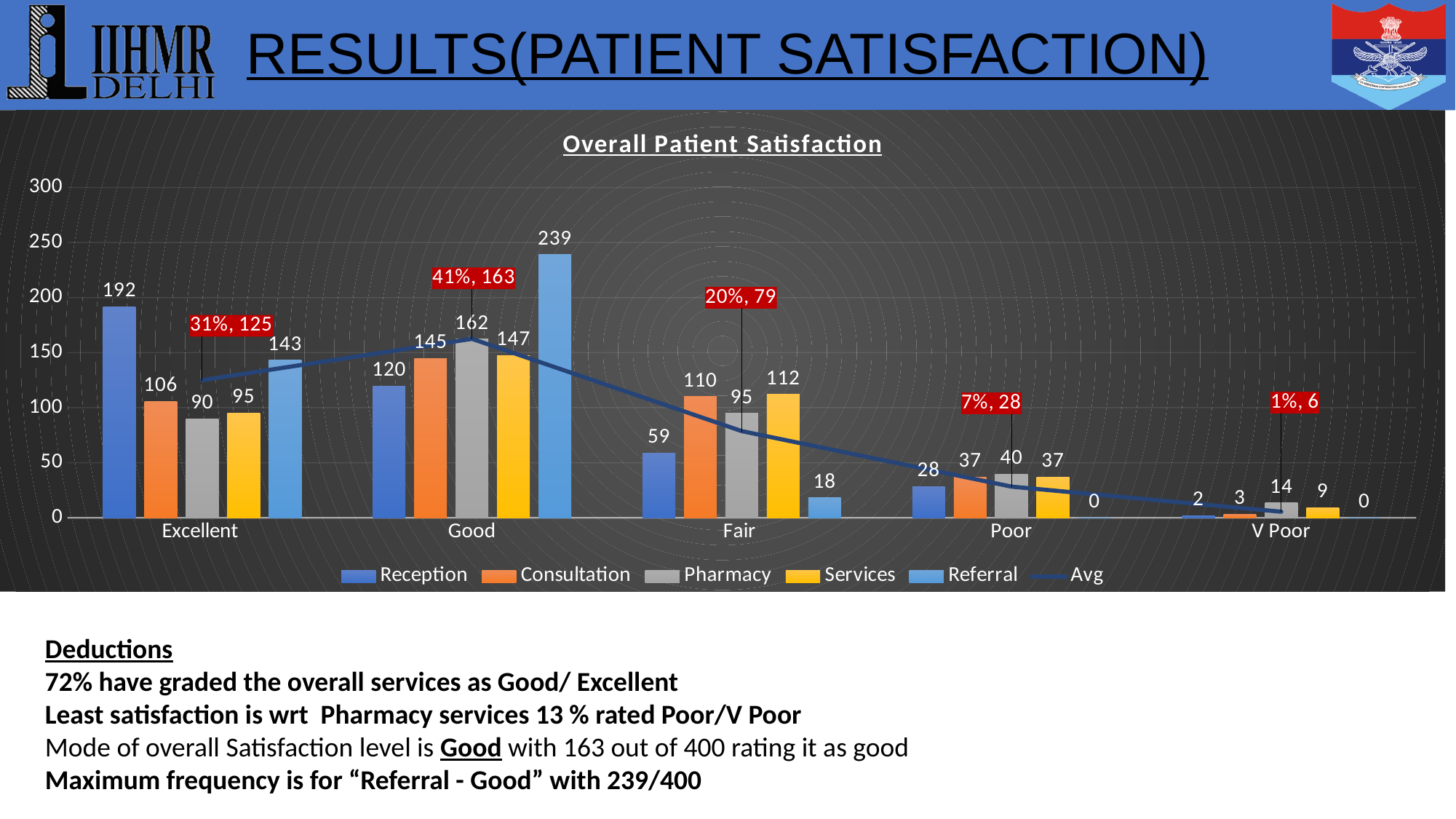
What is the title of the chart? Overall Patient Satisfaction How many series does the legend list? 6 What is the value for Reception in the Excellent category? 192 What is the value for Pharmacy in the V Poor category? 14 How many categories are shown on the x axis? 5 What is the value for Referral in the Good category? 239 Which is larger in the Fair category, Consultation or Services? Services What kind of chart is this? Bar chart with a line Which category has the lowest value for Consultation? V Poor What is the difference between the Pharmacy value and the Reception value in the Good category? 42 Which category has the highest value for Referral? Good What is the Avg data label shown for the Fair category? 20%, 79